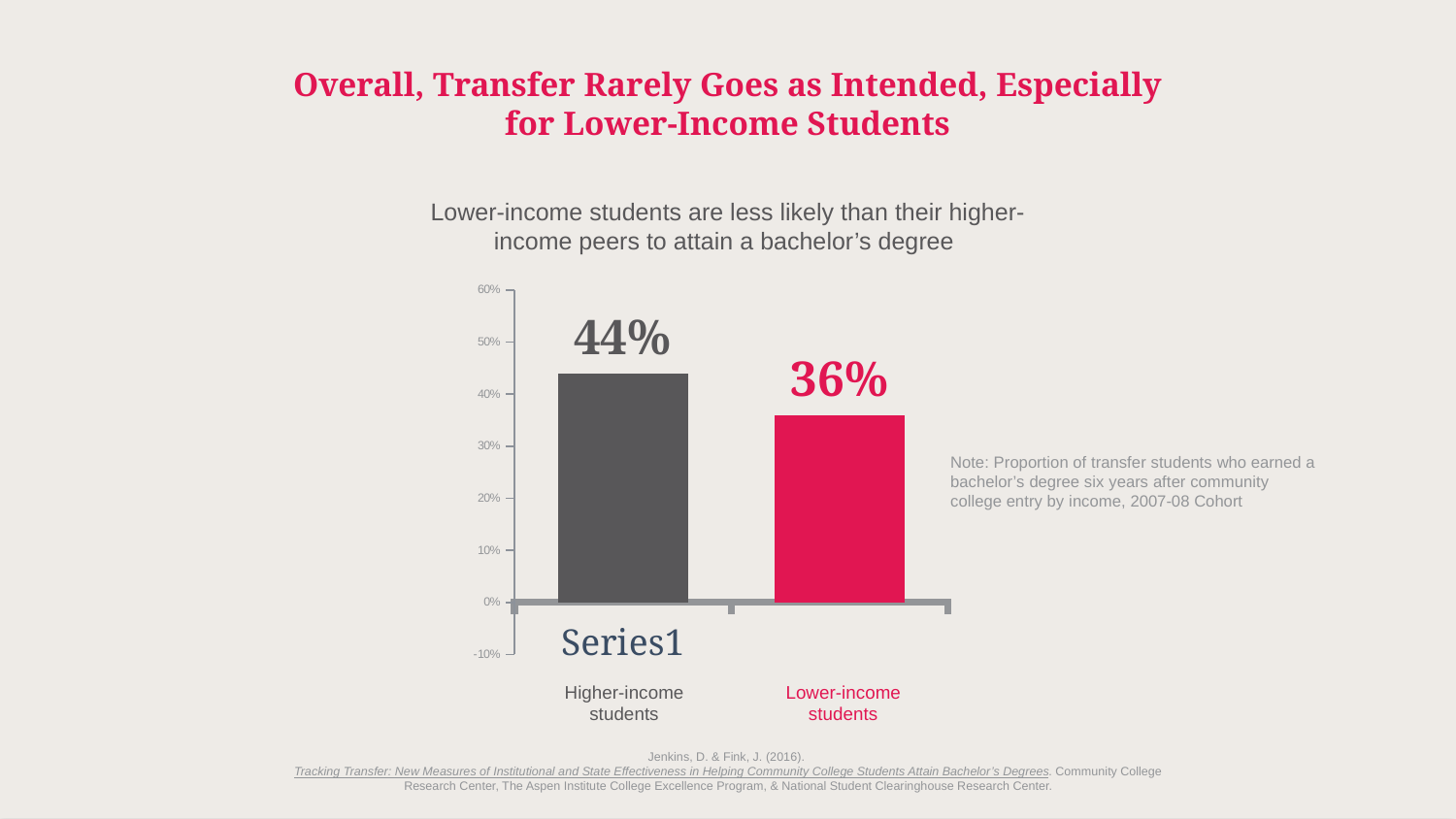
What is the value for Higher-income students? 44% Which group has the higher bachelor's degree attainment rate? Higher-income students What is the highest value shown on the vertical axis? 60% What kind of chart is shown on the slide? Bar chart How many bars are shown in the chart? 2 What colour is the bar for Lower-income students? Red What is the value for Lower-income students? 36% Which group has the lower bachelor's degree attainment rate? Lower-income students Is the value for Higher-income students greater or less than 40%? greater What is the difference between the values for Higher-income students and Lower-income students? 8% Is the value for Lower-income students greater or less than 40%? less